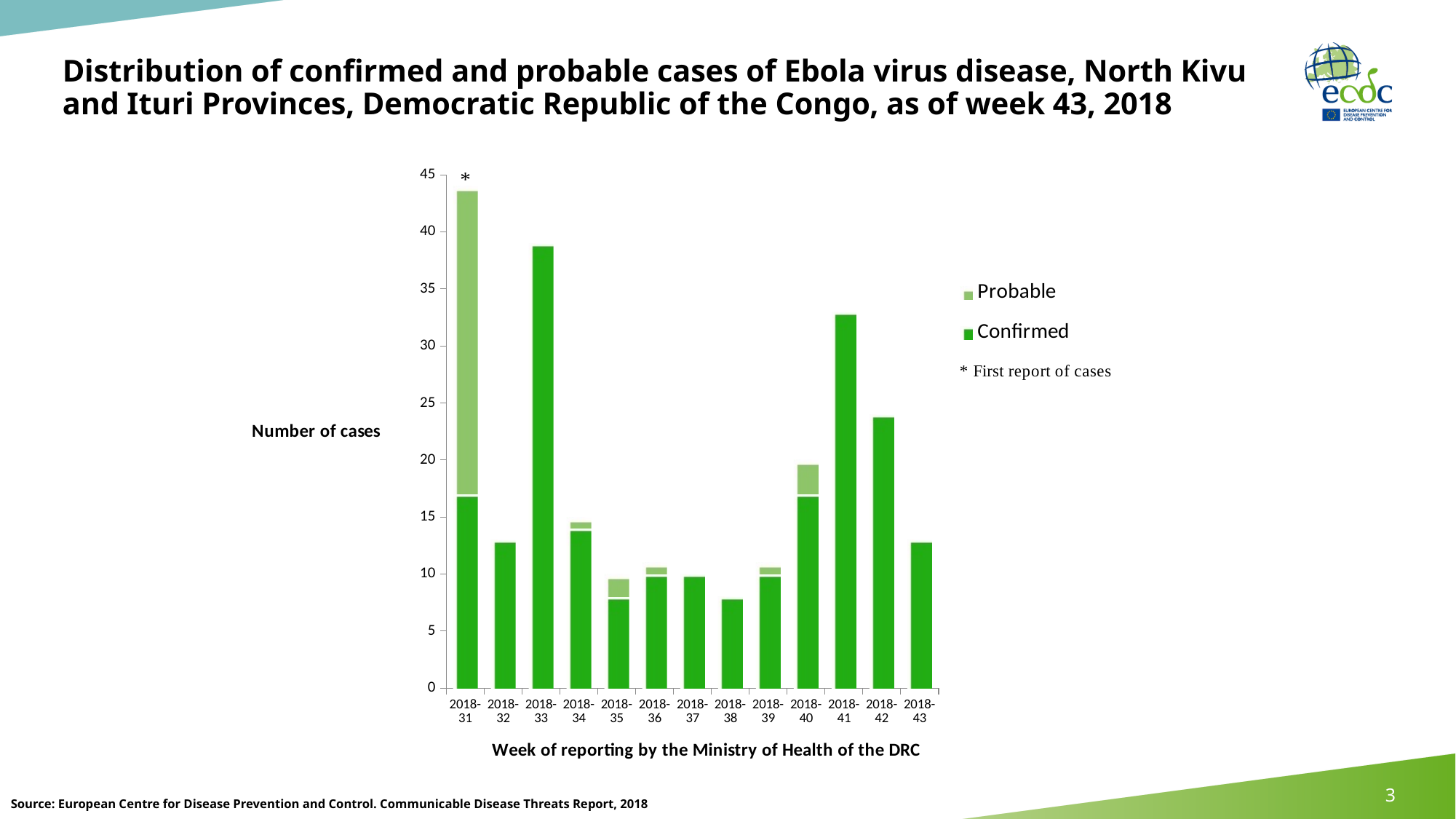
Is the total number of cases for 2018-42 greater or less than 20? greater What kind of chart is shown on the slide? Stacked bar chart Which week has the lowest total number of cases? 2018-38 What does the asterisk above the 2018-31 bar indicate? First report of cases Is the total number of cases for 2018-33 greater or less than 35? greater Which week has the highest total number of cases? 2018-31 How many series does the legend list? 2 Which week has the highest number of confirmed cases? 2018-33 Is the total number of cases for 2018-38 greater or less than 10? less Which week has more total cases, 2018-41 or 2018-42? 2018-41 Do the total number of cases rise or fall from 2018-38 to 2018-41? Rise How many reporting weeks are shown on the x axis? 13